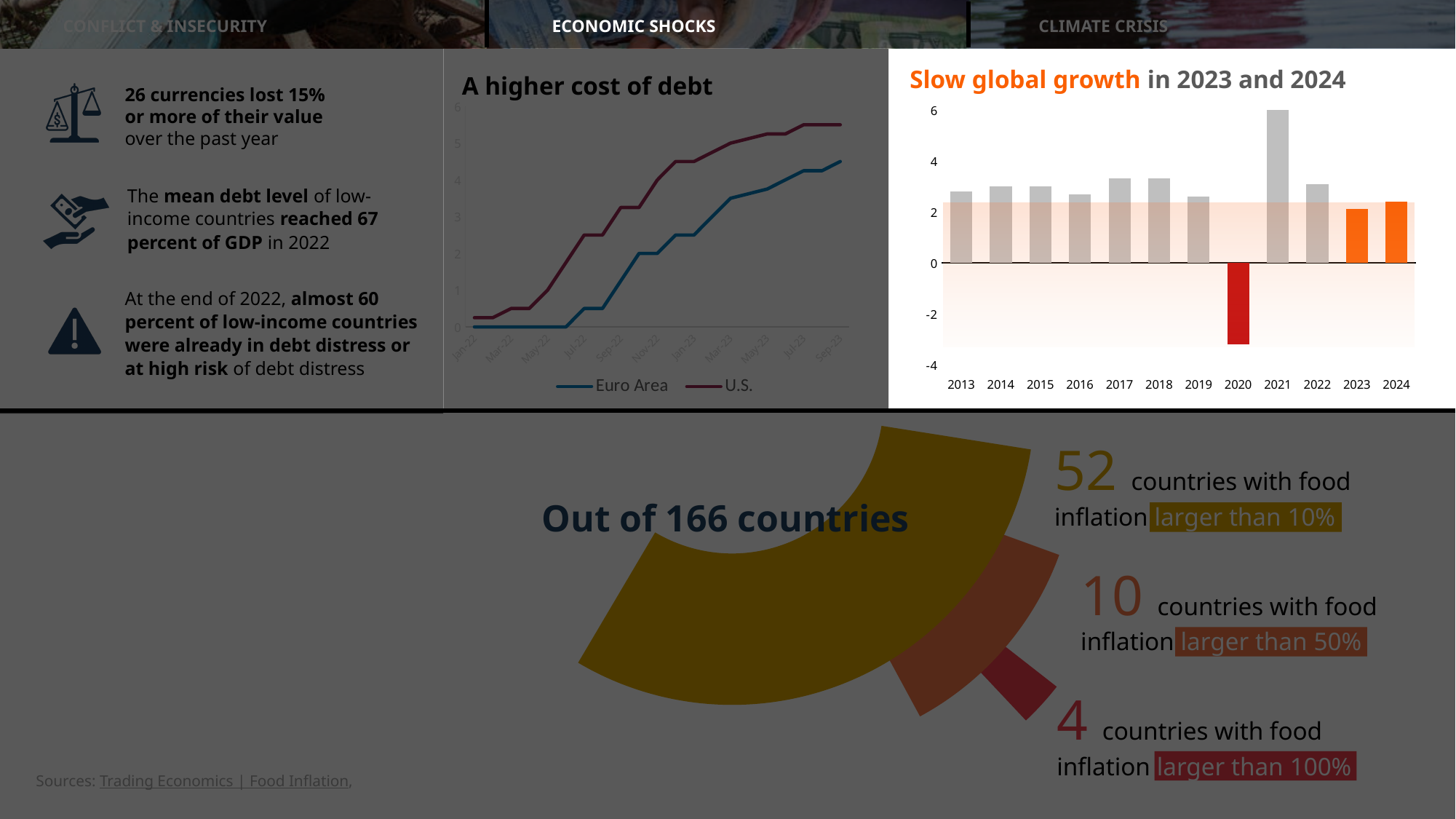
In the 'Slow global growth in 2023 and 2024' chart, is the value for 2020 greater or less than -2? less In the 'Out of 166 countries' graphic, how many countries have food inflation larger than 50%? 10 In the 'A higher cost of debt' chart, which series is higher at Sep-23, Euro Area or U.S.? U.S. How many series does the legend of the 'A higher cost of debt' chart list? 2 In the 'A higher cost of debt' chart, do the values for the U.S. rise or fall from Jan-22 to Sep-23? rise In the 'Slow global growth in 2023 and 2024' chart, is the value for 2021 greater or less than 4? greater In the 'Slow global growth in 2023 and 2024' chart, is the value for 2017 greater or less than 2? greater In the 'Slow global growth in 2023 and 2024' chart, which year has the lowest value? 2020 In the 'Slow global growth in 2023 and 2024' chart, which year has the highest bar? 2021 How many years are shown on the x axis of the 'Slow global growth in 2023 and 2024' chart? 12 What kind of chart is 'Slow global growth in 2023 and 2024'? bar chart